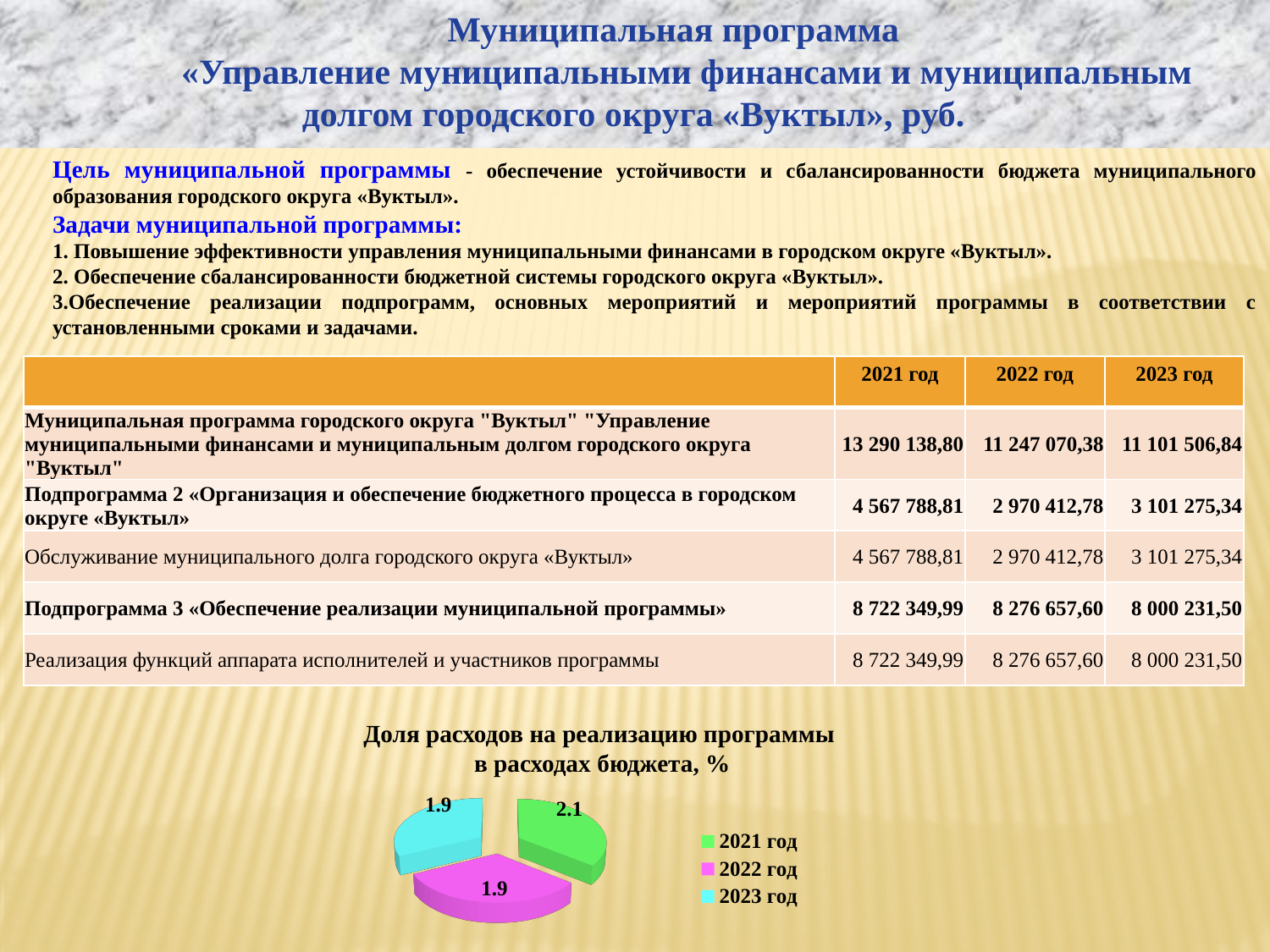
What is the title of the pie chart? Доля расходов на реализацию программы в расходах бюджета, % In the pie chart, what is the value for 2021 год? 2.1 In the pie chart, what is the value for 2022 год? 1.9 In the pie chart, what is the difference between the value for 2021 год and the value for 2023 год? 0.2 What colour is the 2021 год slice in the pie chart? Green In the pie chart, what is the value for 2023 год? 1.9 Is the value for 2021 год in the pie chart greater or less than 2? greater What type of chart is shown at the bottom of the slide? Pie chart How many entries does the legend of the pie chart list? 3 Which year has the largest slice in the pie chart? 2021 год In the pie chart, which is larger: the value for 2021 год or the value for 2022 год? 2021 год How many slices does the pie chart have? 3